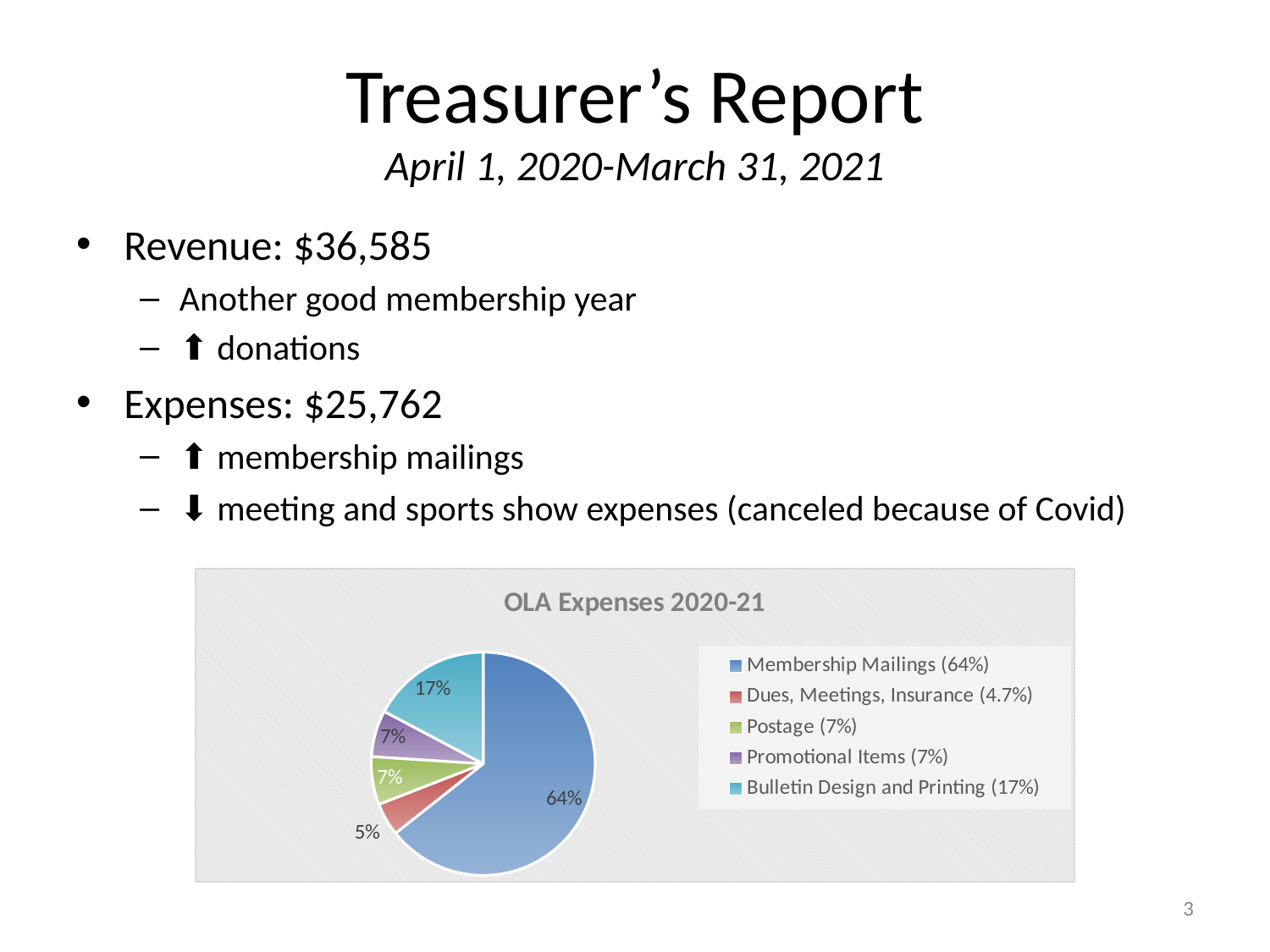
What percentage of OLA expenses 2020-21 is Postage? 7% What percentage of OLA expenses 2020-21 is Membership Mailings? 64% What percentage of OLA expenses 2020-21 is Bulletin Design and Printing? 17% Which is larger in the OLA Expenses 2020-21 chart: Bulletin Design and Printing or Postage? Bulletin Design and Printing What kind of chart is shown on the slide? pie chart How many slices does the OLA Expenses 2020-21 pie chart have? 5 Which category accounts for the smallest share of OLA expenses in 2020-21? Dues, Meetings, Insurance By how many percentage points does Membership Mailings exceed Bulletin Design and Printing in the OLA Expenses 2020-21 chart? 47 percentage points Is the share for Membership Mailings greater or less than 50%? greater Which category accounts for the largest share of OLA expenses in 2020-21? Membership Mailings What is the title of the pie chart on the slide? OLA Expenses 2020-21 What share of the pie does Promotional Items represent? 7%